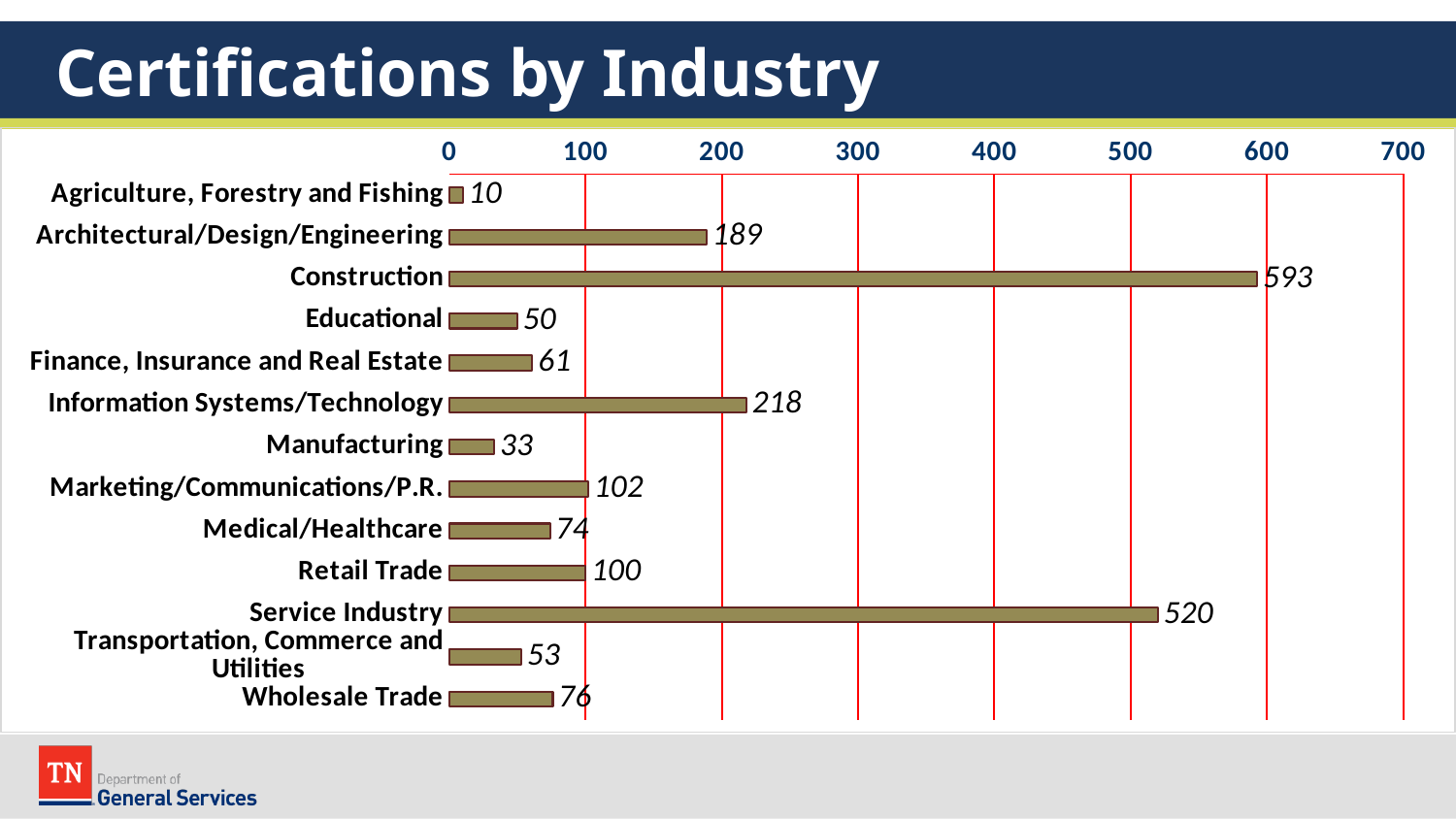
Which is larger, the value for Medical/Healthcare or the value for Wholesale Trade? Wholesale Trade Which industry has the highest number of certifications? Construction What is the title of the slide? Certifications by Industry What is the difference between the values for Information Systems/Technology and Architectural/Design/Engineering? 29 What kind of chart is shown on the slide? Bar chart Which industry has the lowest number of certifications? Agriculture, Forestry and Fishing What is the value for Construction? 593 Which is larger, the value for Educational or the value for Finance, Insurance and Real Estate? Finance, Insurance and Real Estate How many industries are shown in the chart? 13 What is the value for Information Systems/Technology? 218 What is the value for Transportation, Commerce and Utilities? 53 What is the difference between the values for Construction and Service Industry? 73